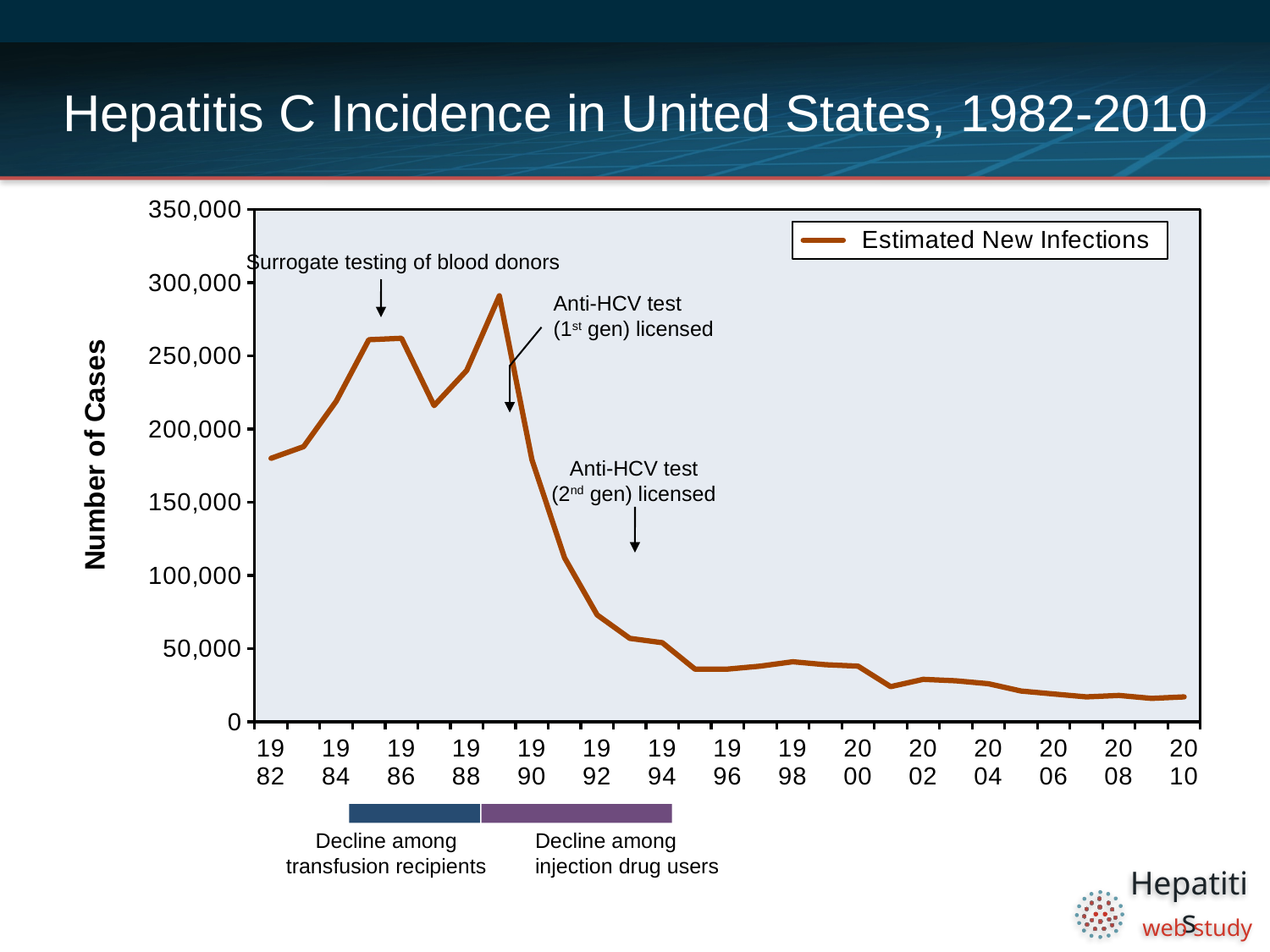
What is the label on the vertical axis? Number of Cases Which year has the larger value, 1986 or 1987? 1986 Which year has the larger value, 1982 or 2010? 1982 Is the value for 2010 greater or less than 50,000? less Is the value for 1989 greater or less than 250,000? greater In which year does the estimated number of new infections reach its highest point? 1989 What is the name of the series shown in the legend? Estimated New Infections Is the value for 1982 greater or less than 150,000? greater How many series does the legend list? 1 Do the values rise or fall from 1989 to 2010? fall What kind of chart is shown on the slide? line chart